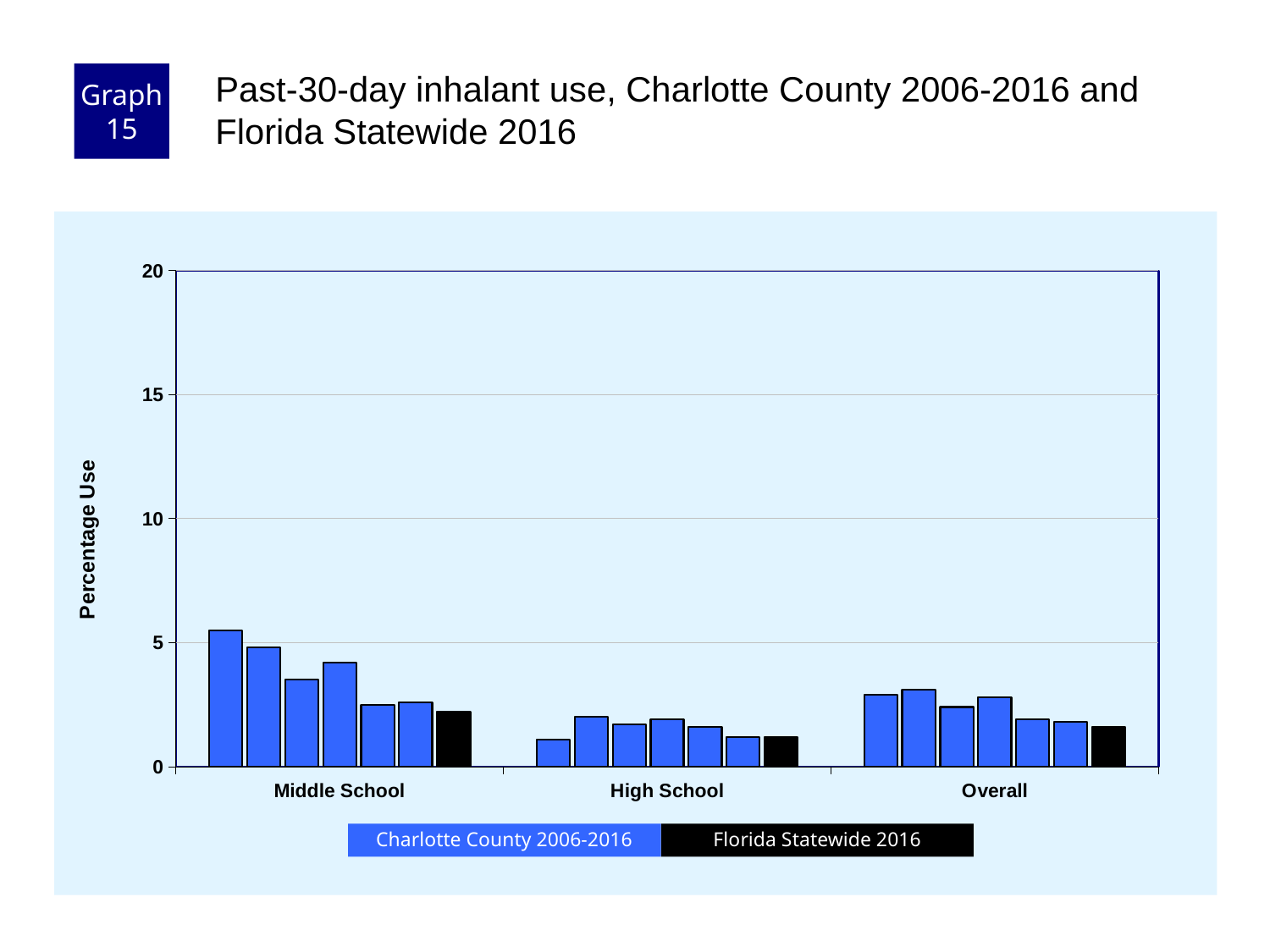
Do the Charlotte County 2006-2016 bars for Middle School generally rise or fall from left to right? fall How many series does the legend list? 2 What kind of chart is shown on the slide? bar chart Is the Florida Statewide 2016 value for Middle School greater or less than 5? less Which is larger, the Florida Statewide 2016 bar for Middle School or the Florida Statewide 2016 bar for High School? Middle School What is the label on the y axis? Percentage Use Which category group contains the tallest bar on the chart? Middle School Is the tallest Middle School bar greater or less than 10? less What colour represents Florida Statewide 2016 in the legend? black How many bars are plotted in the Middle School group? 7 Which category group contains the shortest bar on the chart? High School How many categories are shown on the x axis? 3